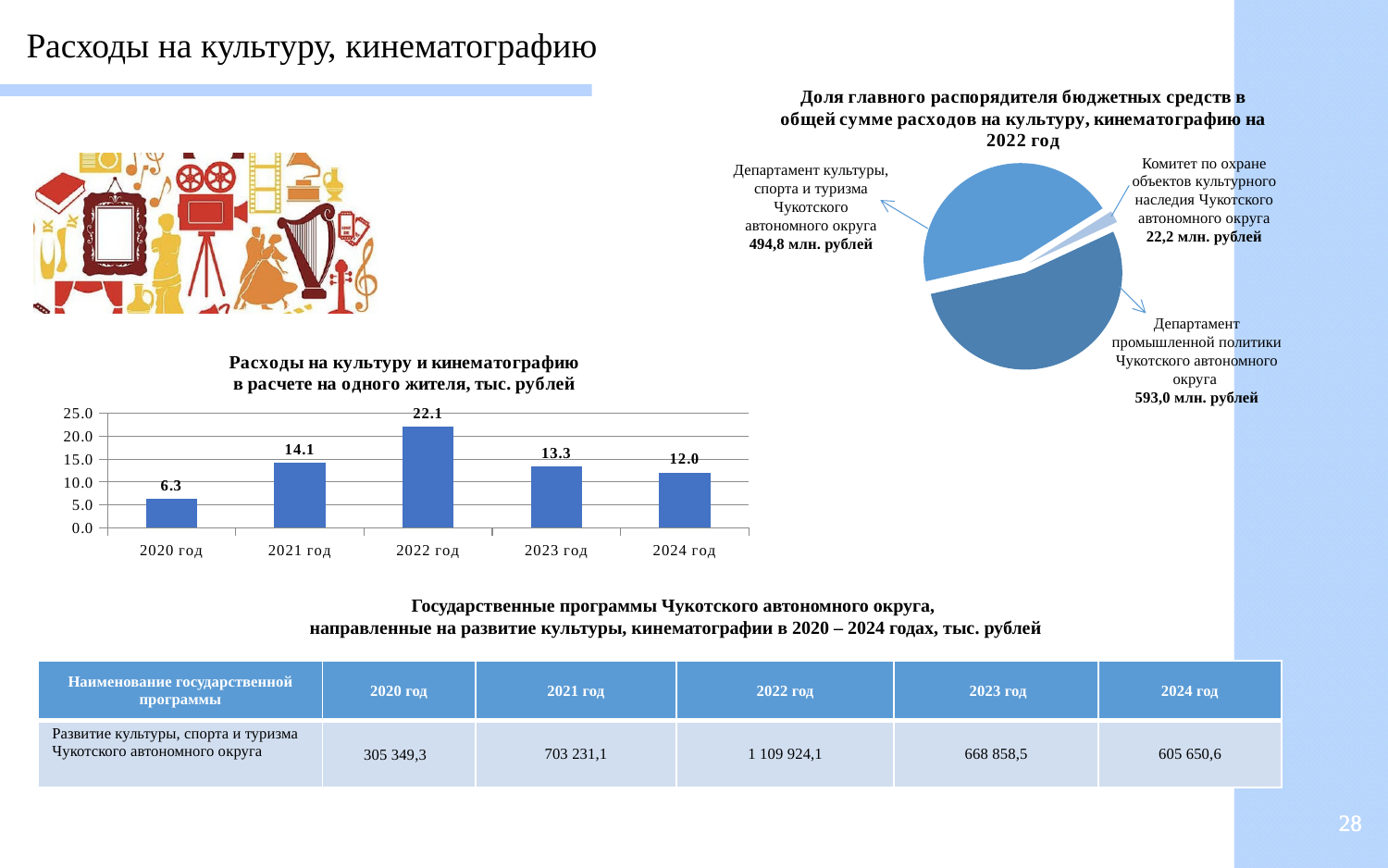
In the bar chart 'Расходы на культуру и кинематографию в расчете на одного жителя', what is the value for 2020 год? 6.3 In the pie chart 'Доля главного распорядителя бюджетных средств в общей сумме расходов на культуру, кинематографию на 2022 год', how many slices are there? 3 In the pie chart 'Доля главного распорядителя бюджетных средств в общей сумме расходов на культуру, кинематографию на 2022 год', which slice is the smallest? Комитет по охране объектов культурного наследия Чукотского автономного округа In the bar chart 'Расходы на культуру и кинематографию в расчете на одного жителя', which year has the lowest value? 2020 год In the bar chart 'Расходы на культуру и кинематографию в расчете на одного жителя', what is the difference between the values for 2022 год and 2023 год? 8.8 In the bar chart 'Расходы на культуру и кинематографию в расчете на одного жителя', which is larger: the value for 2021 год or 2024 год? 2021 год In the bar chart 'Расходы на культуру и кинематографию в расчете на одного жителя', what is the value for 2022 год? 22.1 In the bar chart 'Расходы на культуру и кинематографию в расчете на одного жителя', do the values rise or fall from 2022 год to 2024 год? fall In the pie chart 'Доля главного распорядителя бюджетных средств в общей сумме расходов на культуру, кинематографию на 2022 год', what is the value for Департамент промышленной политики Чукотского автономного округа? 593,0 млн. рублей In the bar chart 'Расходы на культуру и кинематографию в расчете на одного жителя', how many years are shown on the x axis? 5 What kind of chart is 'Расходы на культуру и кинематографию в расчете на одного жителя'? bar chart In the bar chart 'Расходы на культуру и кинематографию в расчете на одного жителя', which year has the highest value? 2022 год